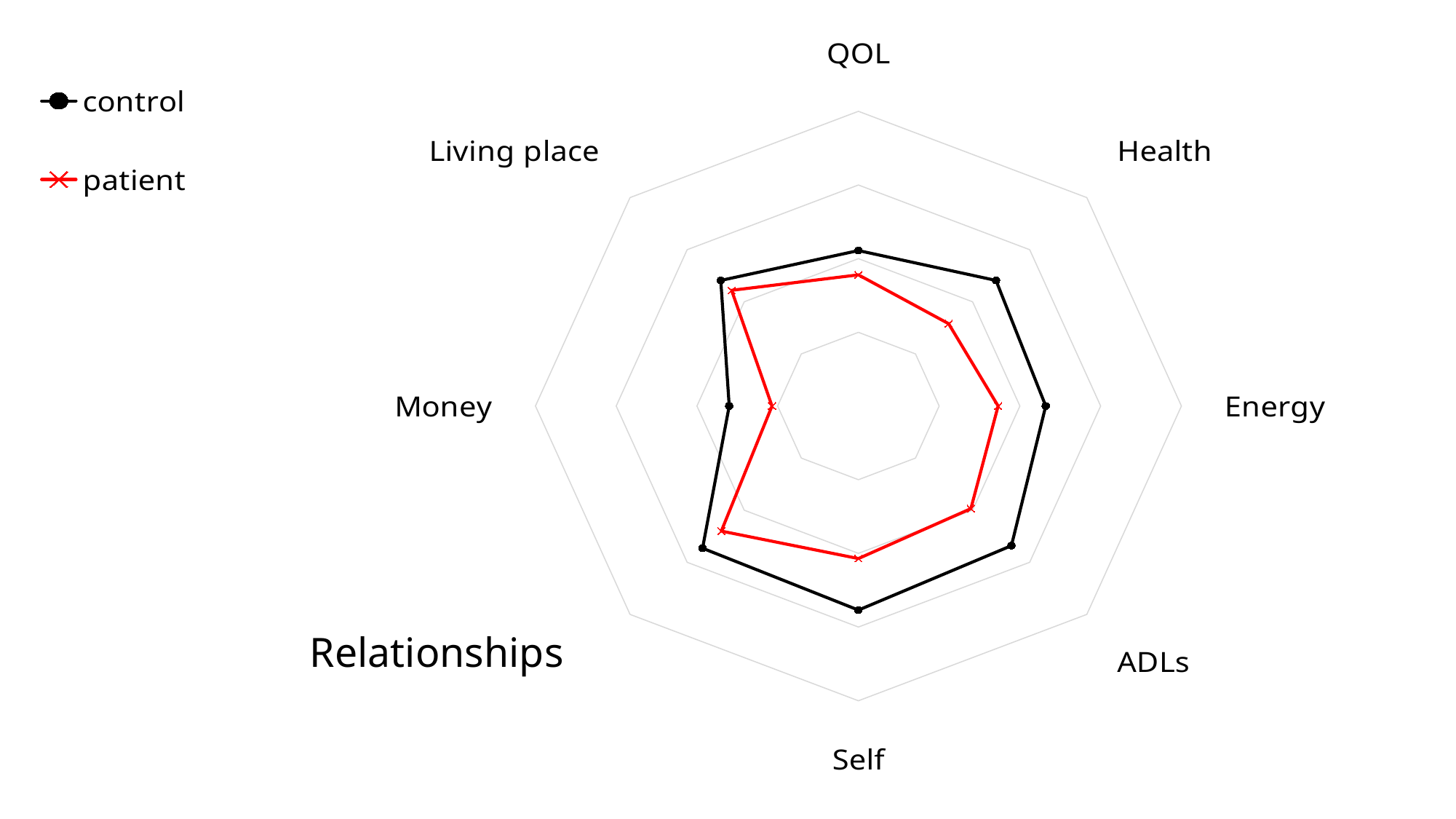
Which series is drawn in red with x markers? patient What kind of chart is shown on the slide? Radar chart Which series has the lower value for Health, control or patient? patient What colour is the control series line? Black Which series has the higher value for QOL, control or patient? control For the control series, which category has the lowest value? Money Which series has the higher value for Self, control or patient? control For the patient series, which category has the lowest value? Money How many categories (axes) does the radar chart have? 8 How many series does the legend list? 2